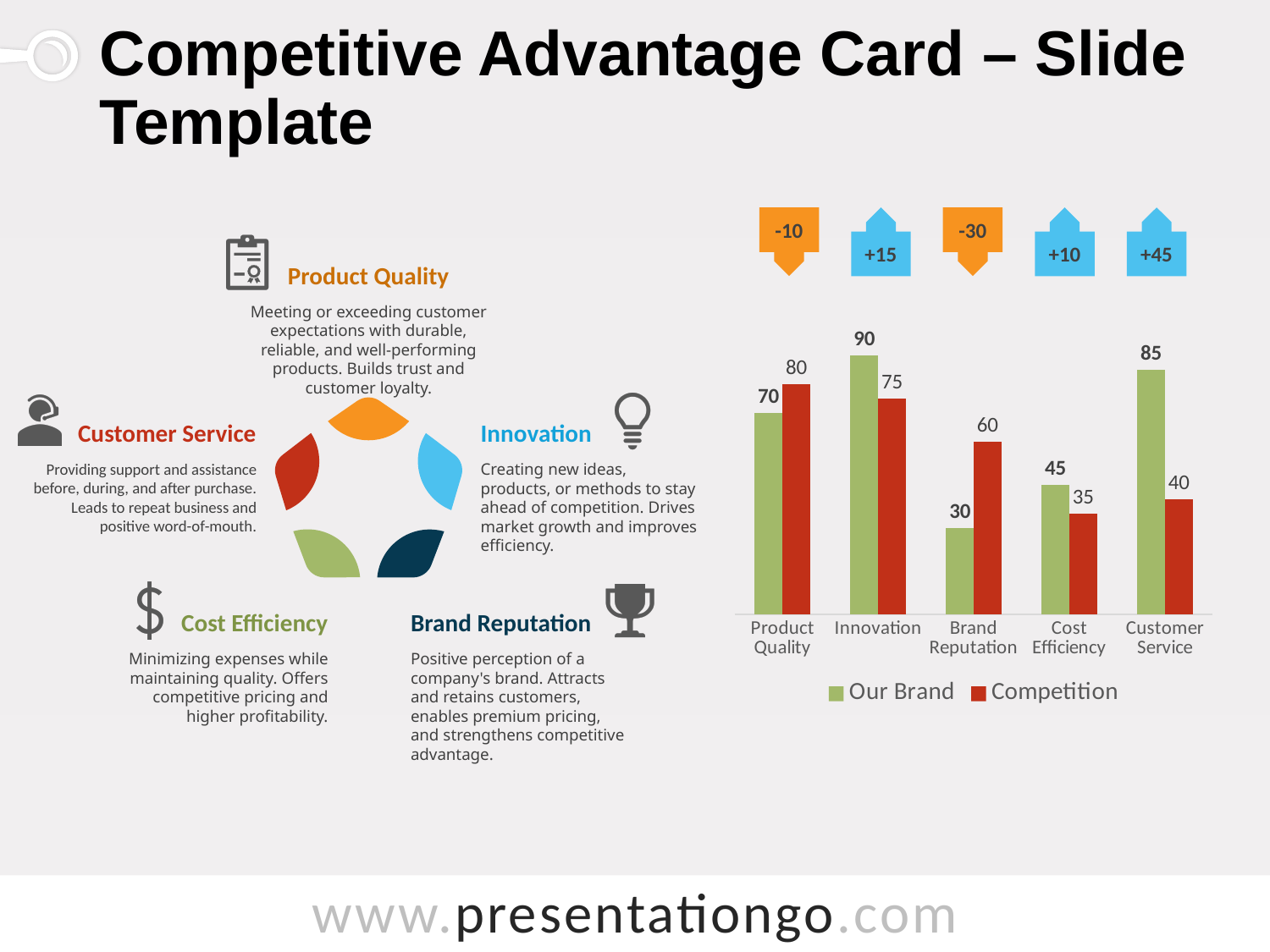
Which colour represents Competition in the chart? Red What is the value for Competition in Brand Reputation? 60 Which category has the lowest value for Competition? Cost Efficiency Which is larger in Brand Reputation, Our Brand or Competition? Competition What is the value for Our Brand in Customer Service? 85 How many categories are shown on the x axis? 5 How many series does the legend list? 2 Which category has the highest value for Our Brand? Innovation What is the difference between Our Brand and Competition in Customer Service? 45 What is the difference between Our Brand and Competition in Innovation? 15 What is the value for Our Brand in Product Quality? 70 What kind of chart is shown on the slide? Bar chart